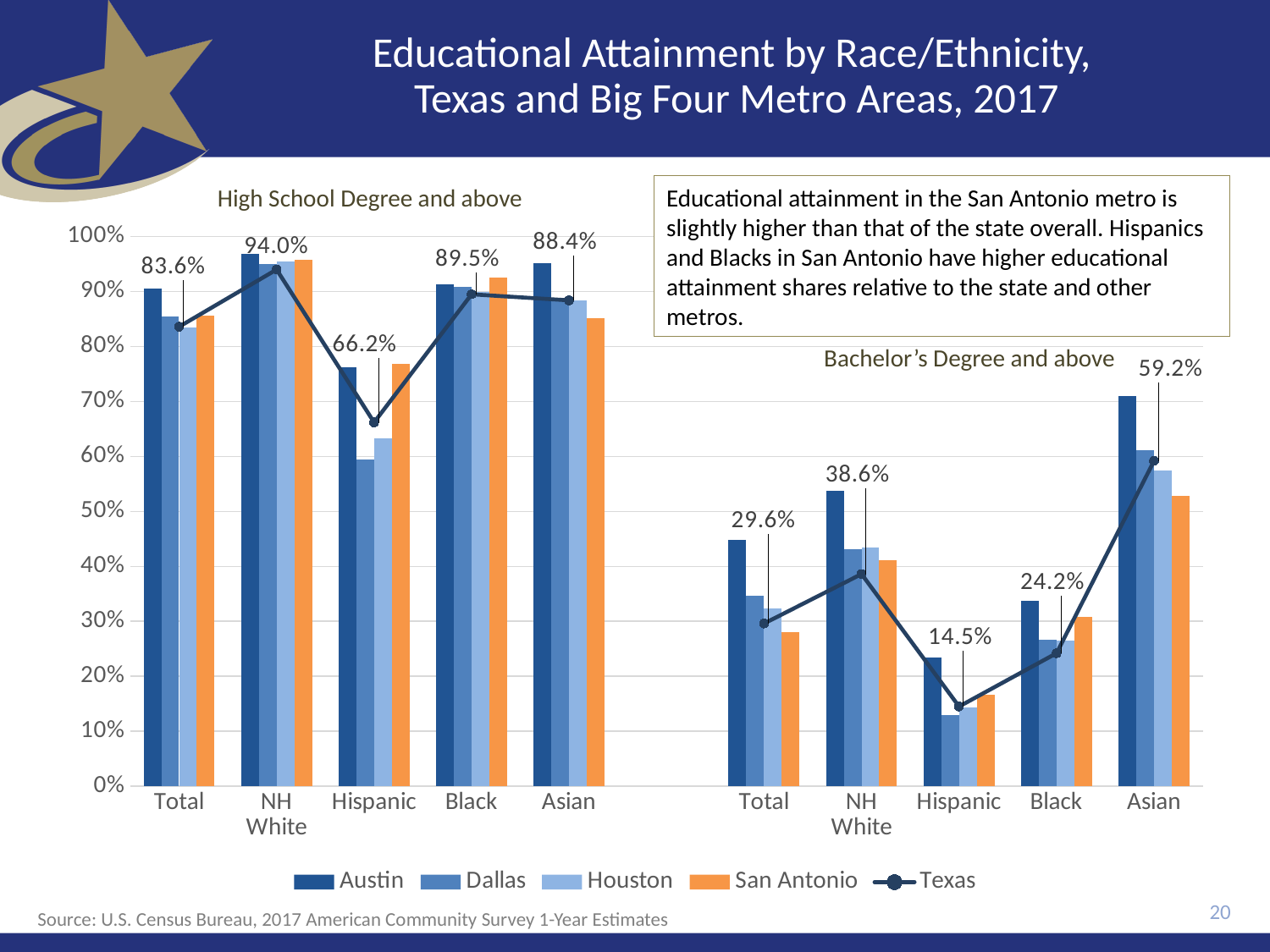
In the Bachelor's Degree and above section, which category has the highest Texas value? Asian In the Bachelor's Degree and above section, is the Austin value for Asian greater or less than 60%? greater What is the source cited at the bottom of the slide? U.S. Census Bureau, 2017 American Community Survey 1-Year Estimates What is the Texas value for Hispanic in the High School Degree and above section? 66.2% What is the Texas value for Asian in the Bachelor's Degree and above section? 59.2% In the Bachelor's Degree and above section, is the Texas value for NH White or Black larger? NH White How many series does the legend list? 5 In the High School Degree and above section, what is the difference between the Texas values for NH White and Hispanic? 27.8 percentage points What is the Texas value for Total in the Bachelor's Degree and above section? 29.6% In the High School Degree and above section, which category has the lowest Texas value? Hispanic What kind of chart is shown on the slide? Combined bar and line chart In the High School Degree and above section, is the Dallas value for Hispanic greater or less than 70%? less